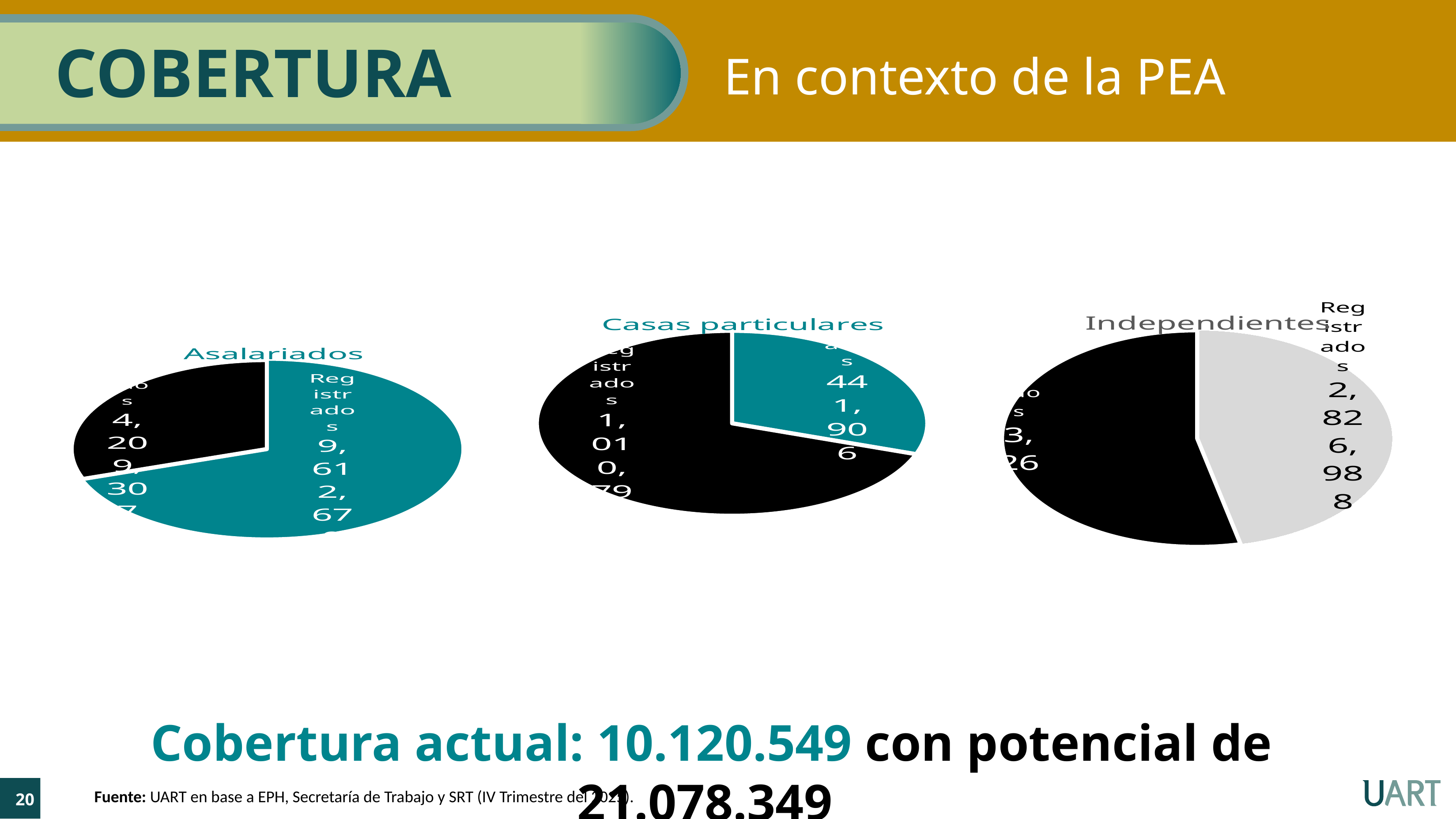
In the Casas particulares pie chart, what value is printed on the teal slice? 441,906 In the Asalariados pie chart, what value is printed on the black slice? 4,209,307 In the Independientes pie chart, what colour is the Registrados slice? grey How many slices does the Casas particulares pie chart have? 2 What are the titles of the three pie charts on the slide? Asalariados, Casas particulares, Independientes How many pie charts are shown on the slide? 3 In the Independientes pie chart, what value is shown for Registrados? 2,826,988 What kind of chart is the Asalariados chart? pie chart In the Asalariados pie chart, which slice is larger, the teal one or the black one? teal In the Casas particulares pie chart, which slice is larger, the black one or the teal one? black